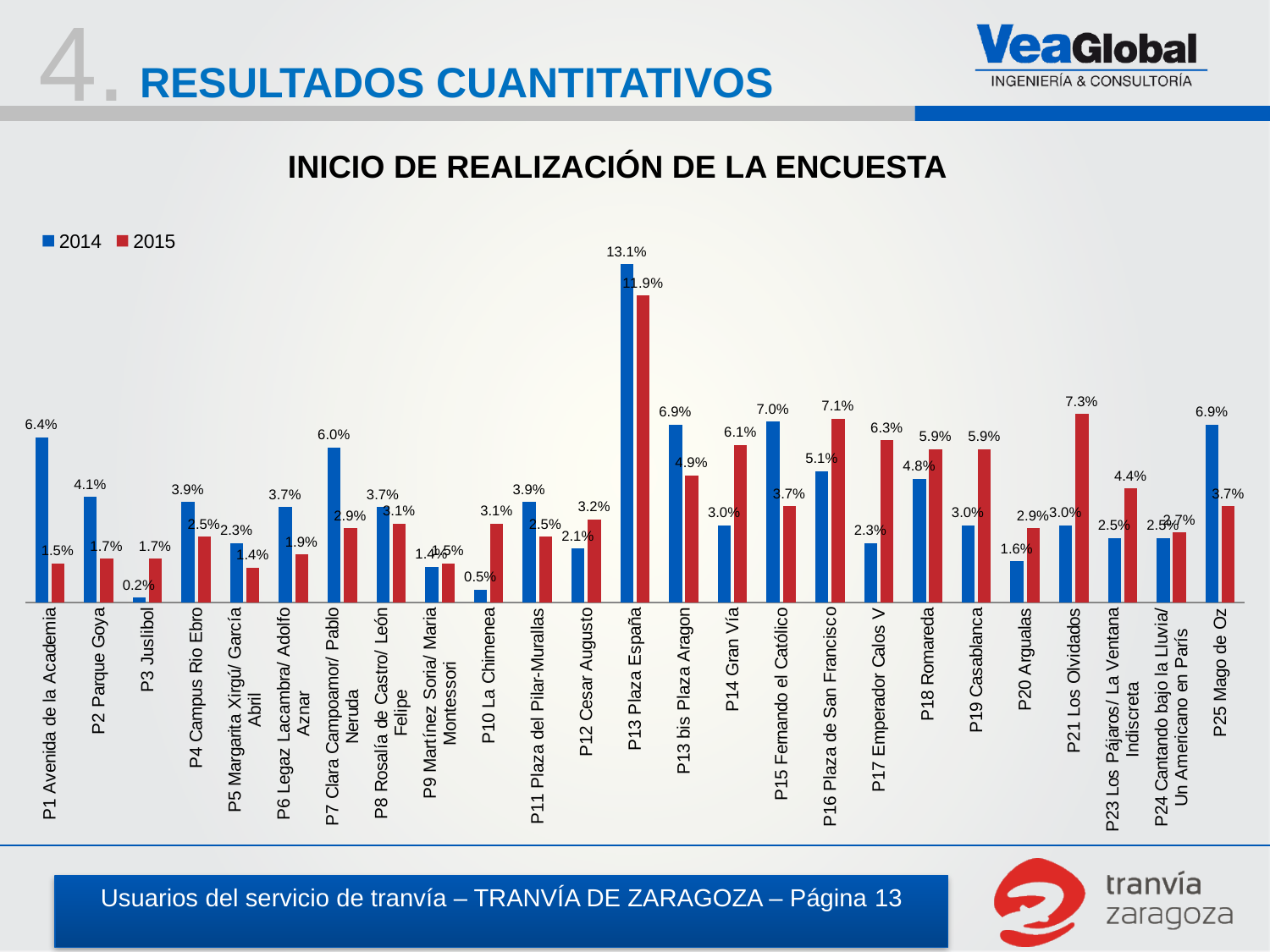
How many series does the legend list? 2 For P25 Mago de Oz, which year has the larger value, 2014 or 2015? 2014 What is the 2014 value for P13 Plaza España? 13.1% What is the 2014 value for P3 Juslibol? 0.2% How many categories (stops) are shown on the x axis? 25 Which category has the highest 2015 value? P13 Plaza España What is the difference between the 2014 and 2015 values for P1 Avenida de la Academia? 4.9% What is the 2015 value for P21 Los Olvidados? 7.3% What is the title of the chart? INICIO DE REALIZACIÓN DE LA ENCUESTA For P17 Emperador Calos V, which year has the larger value, 2014 or 2015? 2015 Which category has the lowest 2014 value? P3 Juslibol What type of chart is shown on the slide? bar chart